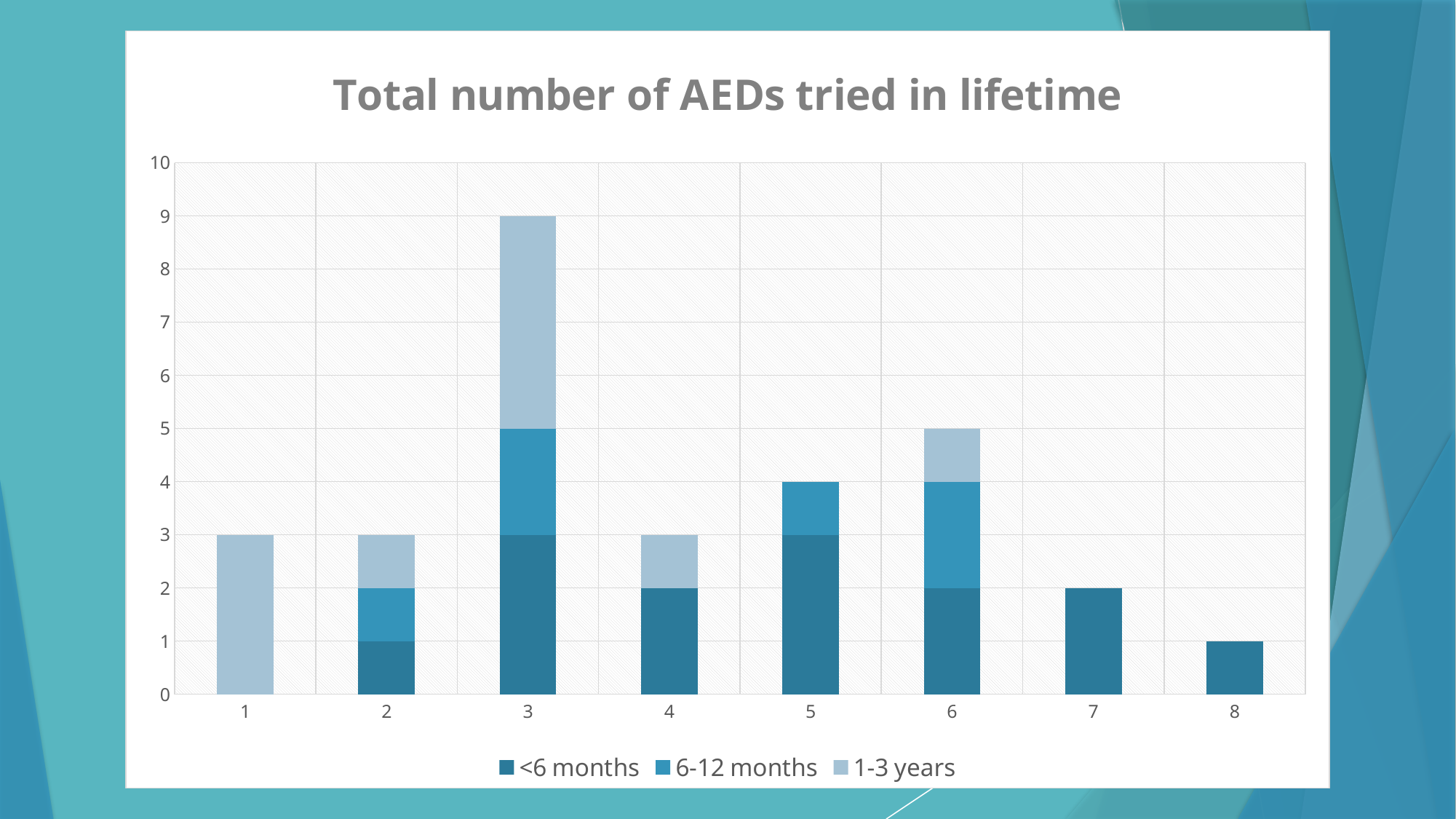
How many series does the legend list? 3 What is the total height of the stacked bar for category 6? 5 What is the difference between the total for category 3 and the total for category 6? 4 What is the total height of the stacked bar for category 3? 9 What kind of chart is shown on the slide? Stacked bar chart What is the title of the chart? Total number of AEDs tried in lifetime Which category has the tallest stacked bar? 3 How many categories are shown on the x axis? 8 Which stacked bar is taller, category 5 or category 6? 6 What is the value of the <6 months segment for category 5? 3 Which category has the shortest stacked bar? 8 What is the value of the <6 months segment for category 7? 2